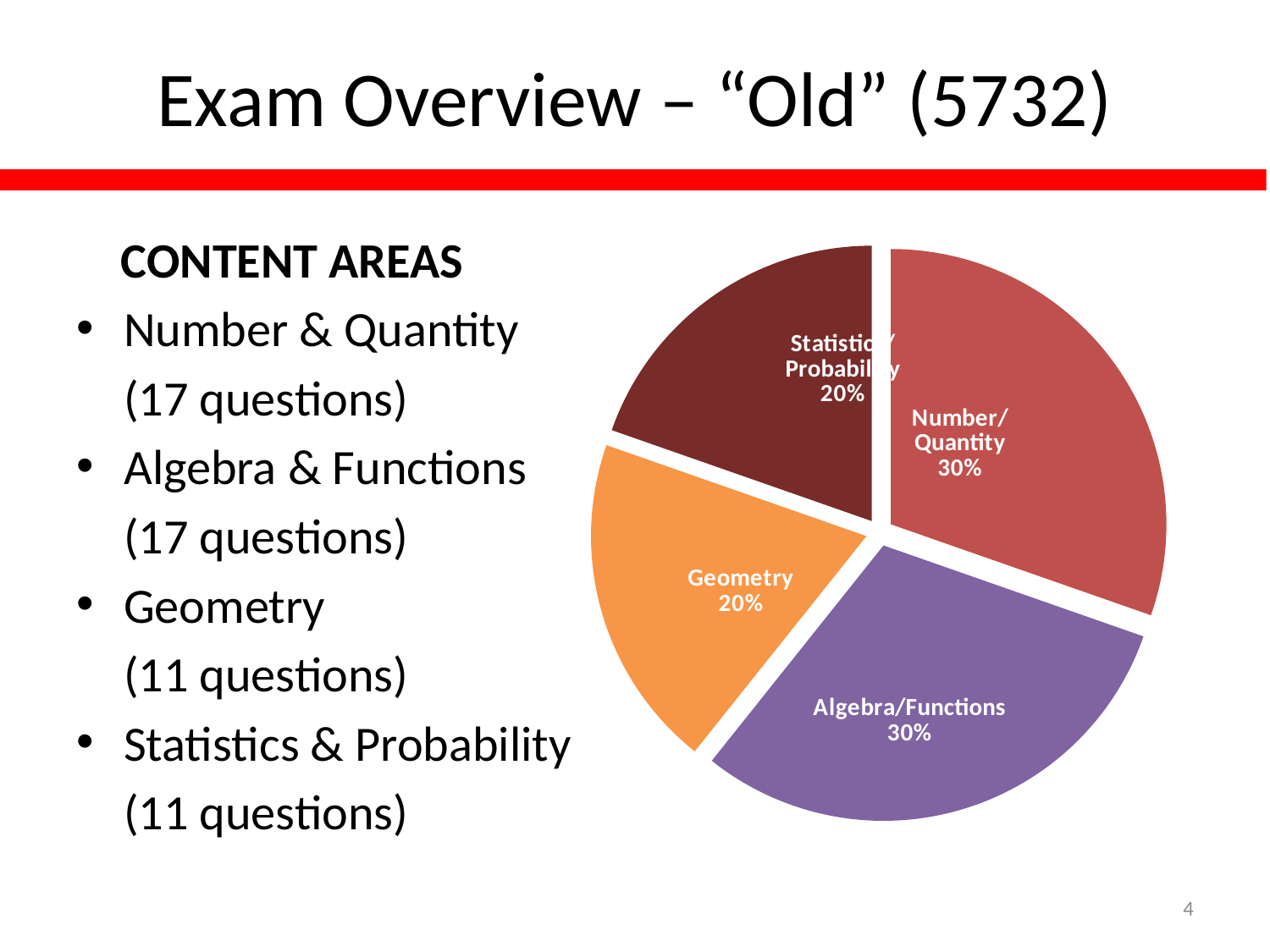
What colour is the Algebra/Functions slice in the pie chart? Purple What is the difference in percentage points between the Algebra/Functions slice and the Geometry slice? 10 percentage points How many slices does the pie chart have? 4 Which slice is larger, Statistics/Probability or Algebra/Functions? Algebra/Functions What percentage of the pie chart does Number/Quantity represent? 30% What kind of chart is shown on the slide? Pie chart What percentage of the pie chart does Geometry represent? 20% What percentage of the pie chart does Algebra/Functions represent? 30% What share of the pie does the Geometry slice take up? 20% What percentage of the pie chart does Statistics/Probability represent? 20% Which slice is larger, Number/Quantity or Geometry? Number/Quantity What colour is the Geometry slice in the pie chart? Orange